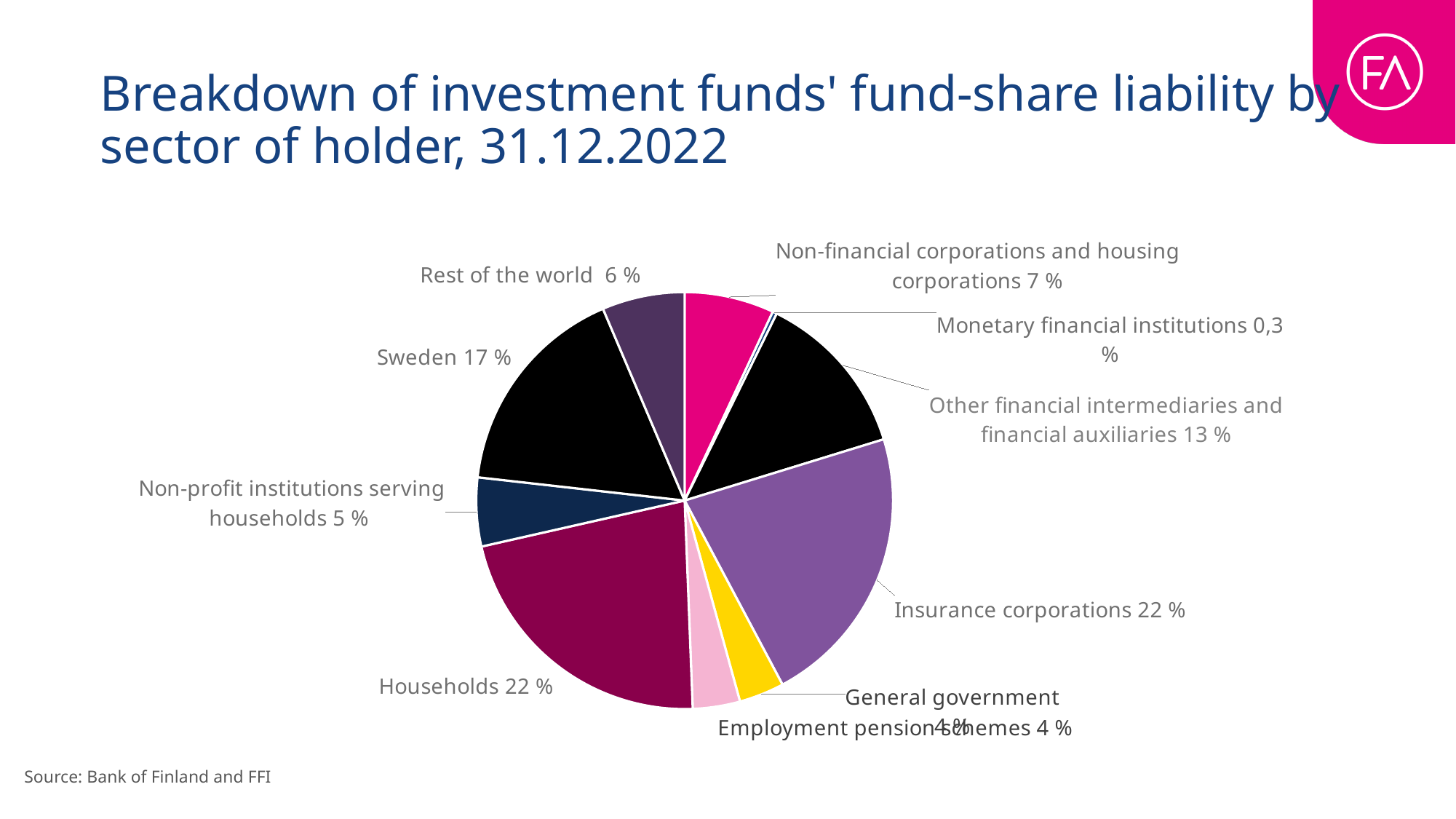
What kind of chart is shown on the slide? Pie chart Which sector holds the smallest share of the pie? Monetary financial institutions What share is held by Other financial intermediaries and financial auxiliaries? 13 % What share is held by Non-profit institutions serving households? 5 % What share of investment funds' fund-share liability is held by Sweden? 17 % What share is held by Households? 22 % Which holds a larger share, Sweden or Rest of the world? Sweden What share is held by Insurance corporations? 22 % How many sectors (slices) are shown in the pie chart? 10 What share is held by Non-financial corporations and housing corporations? 7 % How many percentage points larger is Sweden's share than that of Other financial intermediaries and financial auxiliaries? 4 % What share is held by Rest of the world? 6 %